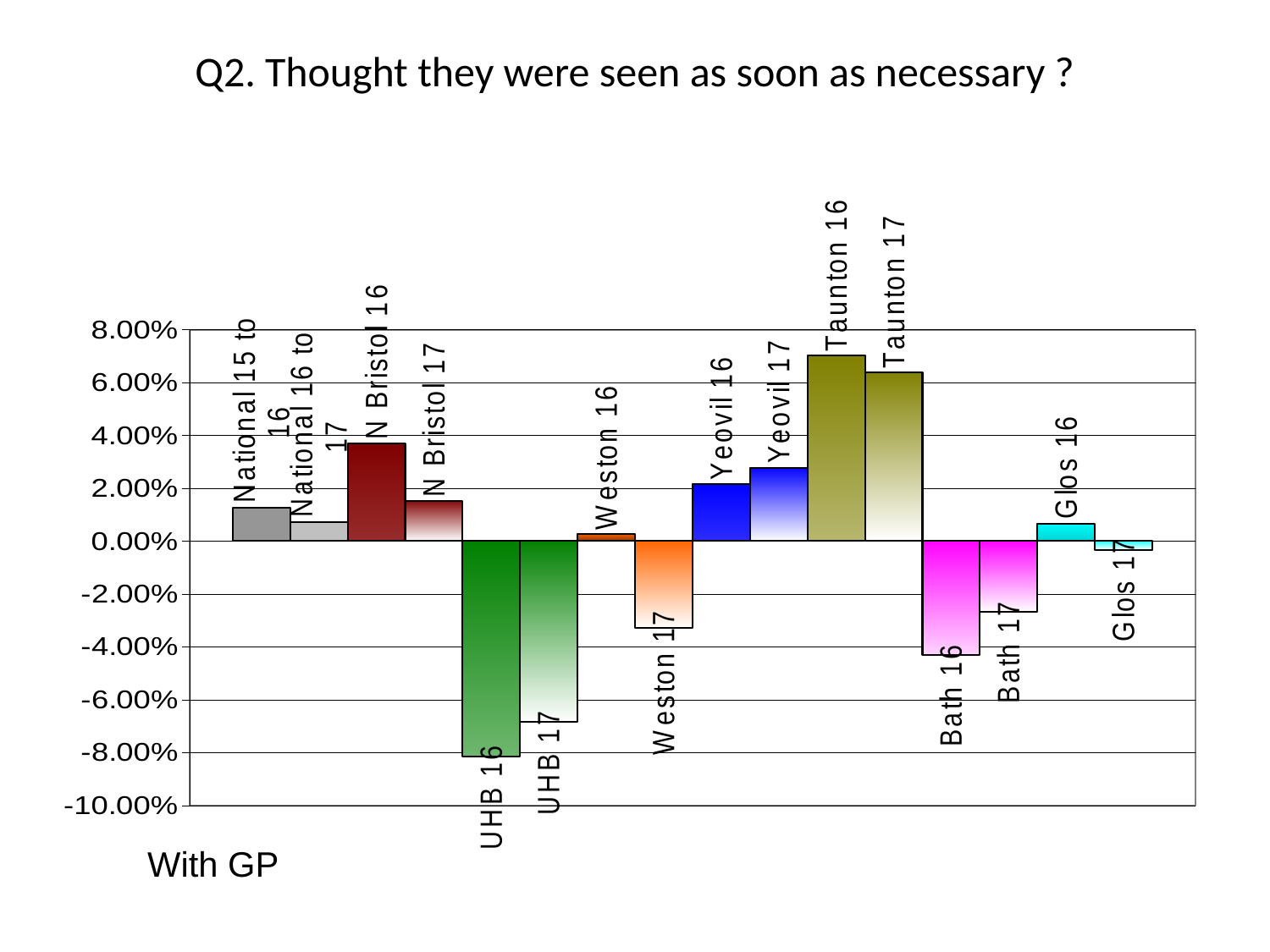
Is the value for Taunton 16 greater or less than 6.00%? greater Which is larger, the value for Yeovil 16 or Yeovil 17? Yeovil 17 Which is larger, the value for Taunton 16 or Taunton 17? Taunton 16 Which is larger, the value for UHB 16 or UHB 17? UHB 17 Is the value for N Bristol 16 greater or less than 2.00%? greater Which category has the lowest value in the chart? UHB 16 Is the value for Weston 17 greater or less than -2.00%? less What is the title of the chart on the slide? Q2. Thought they were seen as soon as necessary ? How many bars (categories) are plotted in the chart? 16 What kind of chart is shown on the slide? Bar chart Which category has the highest value in the chart? Taunton 16